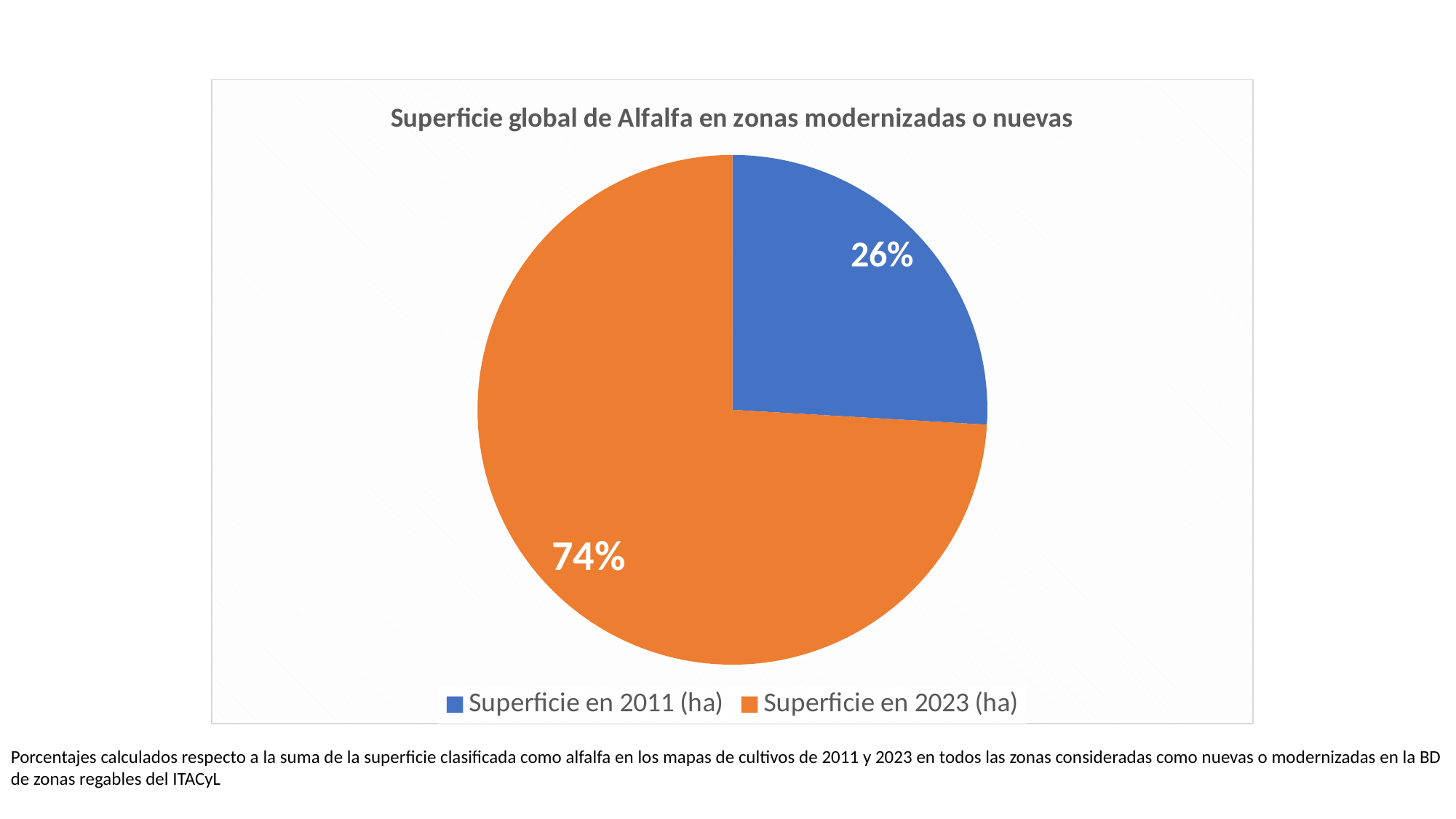
What is the difference in percentage points between the 2023 slice and the 2011 slice? 48 What colour is the slice for "Superficie en 2011 (ha)"? blue Which is larger, the share for 2011 or the share for 2023? Superficie en 2023 (ha) What share of the pie does "Superficie en 2023 (ha)" represent? 74% Is the share for "Superficie en 2011 (ha)" greater or less than 50%? less What share of the pie does "Superficie en 2011 (ha)" represent? 26% What kind of chart is shown on the slide? pie chart What is the title of the chart? Superficie global de Alfalfa en zonas modernizadas o nuevas Which slice is the smallest? Superficie en 2011 (ha) How many entries does the legend list? 2 How many slices does the pie chart have? 2 Which slice is the largest? Superficie en 2023 (ha)